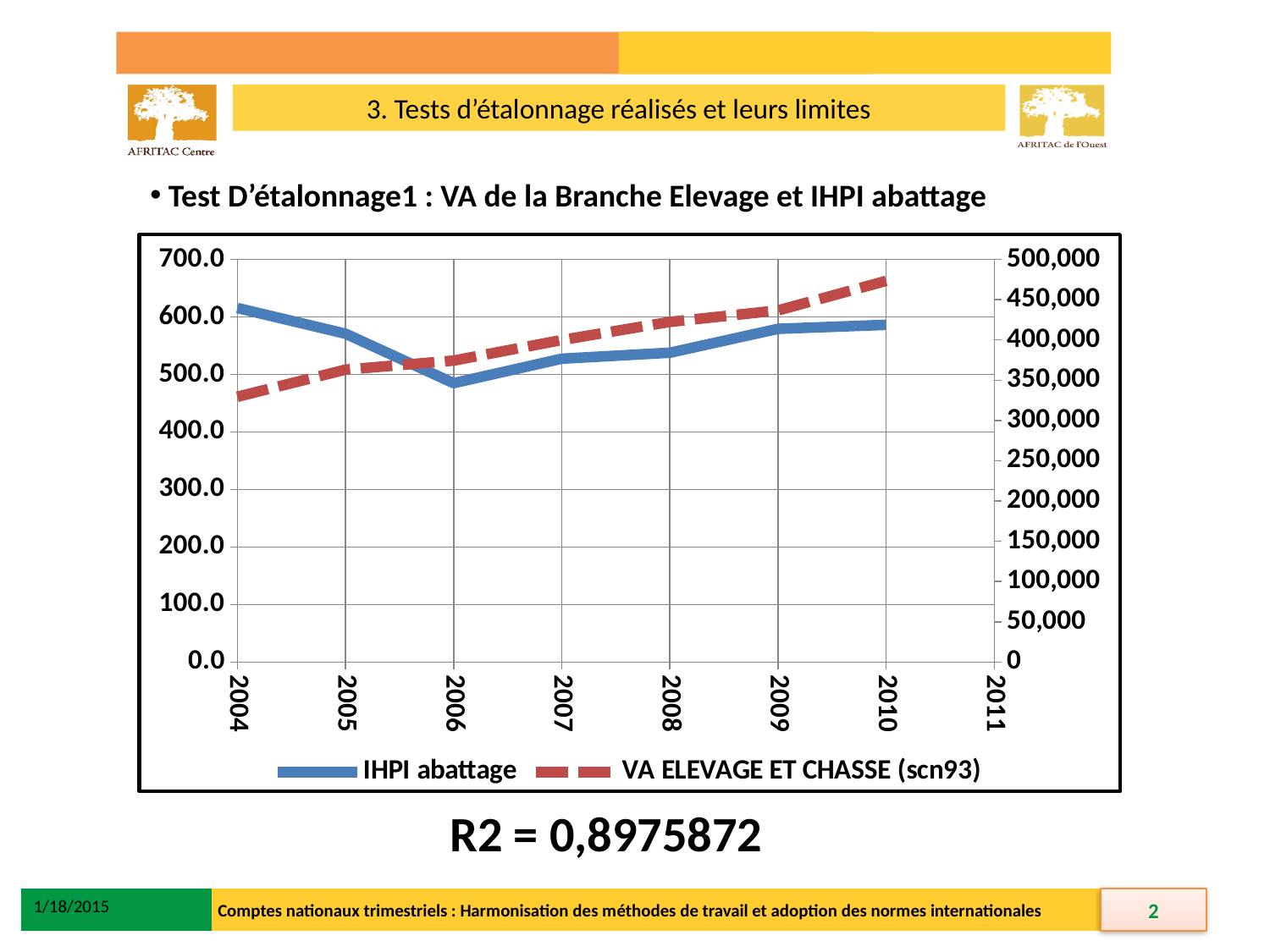
What are the two series named in the chart legend? IHPI abattage and VA ELEVAGE ET CHASSE (scn93) In which year does the IHPI abattage series reach its lowest value? 2006 Is the VA ELEVAGE ET CHASSE (scn93) value for 2010 greater or less than 400,000? greater Is the IHPI abattage value for 2006 greater or less than 600? less What R2 value is printed below the chart? R2 = 0,8975872 In which year does the VA ELEVAGE ET CHASSE (scn93) series have its lowest value? 2004 Is the IHPI abattage value for 2004 greater or less than 500? greater Does the VA ELEVAGE ET CHASSE (scn93) series generally rise or fall from 2004 to 2010? Rise What kind of chart is shown on the slide? Line chart In which year does the VA ELEVAGE ET CHASSE (scn93) series reach its highest value? 2010 Which is larger for IHPI abattage: the value in 2004 or the value in 2006? 2004 How many series does the chart legend list? 2